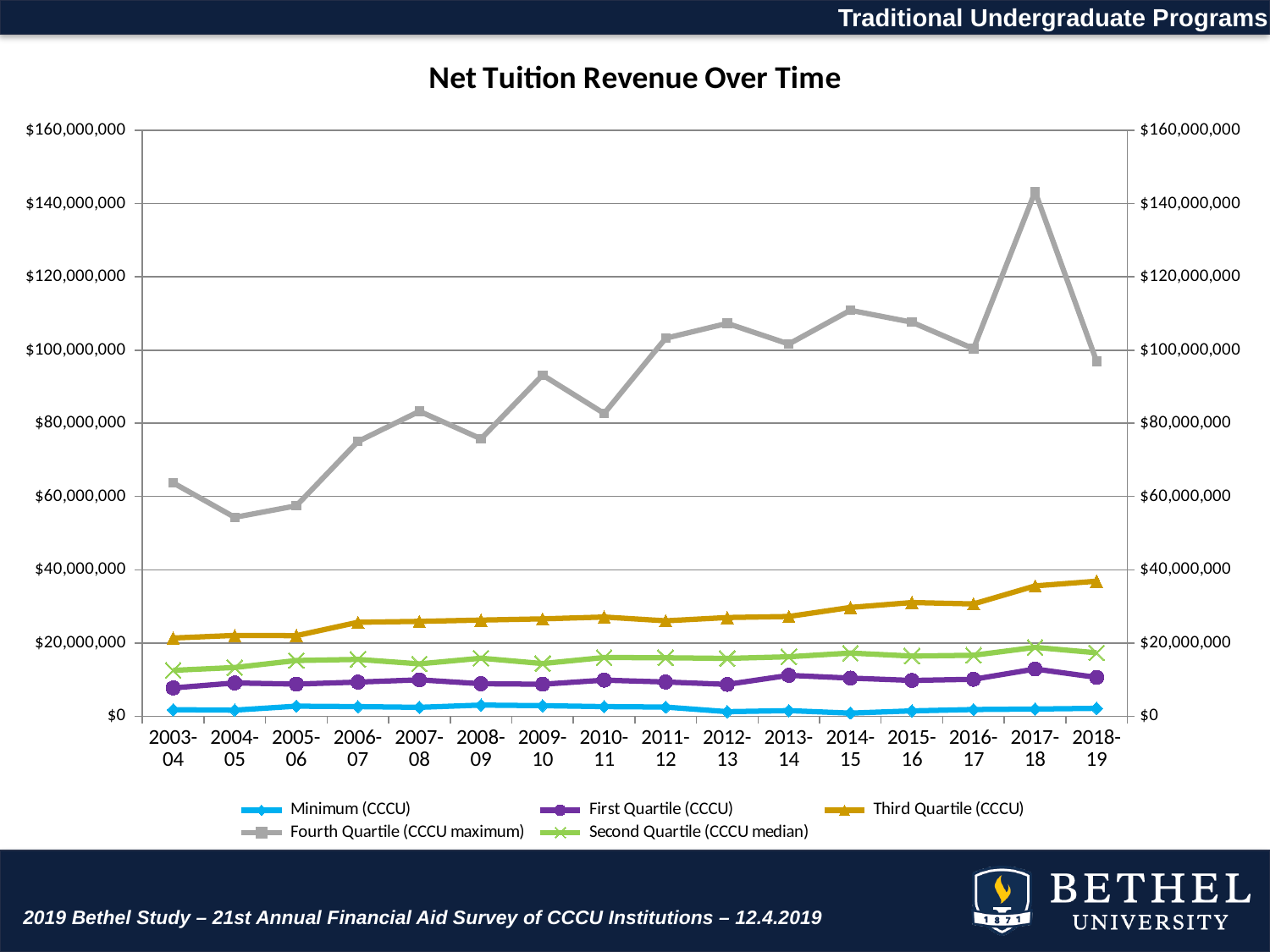
For the Fourth Quartile (CCCU maximum) series, which is larger: the value for 2014-15 or the value for 2016-17? 2014-15 What is the title of the chart? Net Tuition Revenue Over Time How many academic years are plotted along the x axis? 16 Is the Fourth Quartile (CCCU maximum) value for 2011-12 greater or less than $100,000,000? greater How many series does the legend list? 5 Is the Fourth Quartile (CCCU maximum) value for 2017-18 greater or less than $120,000,000? greater Is the Fourth Quartile (CCCU maximum) value for 2003-04 greater or less than $60,000,000? greater What kind of chart is shown on the slide? line chart In which year does the Fourth Quartile (CCCU maximum) series reach its highest value? 2017-18 In which year is the Fourth Quartile (CCCU maximum) series at its lowest? 2004-05 Does the Third Quartile (CCCU) series generally rise or fall from 2003-04 to 2018-19? rise